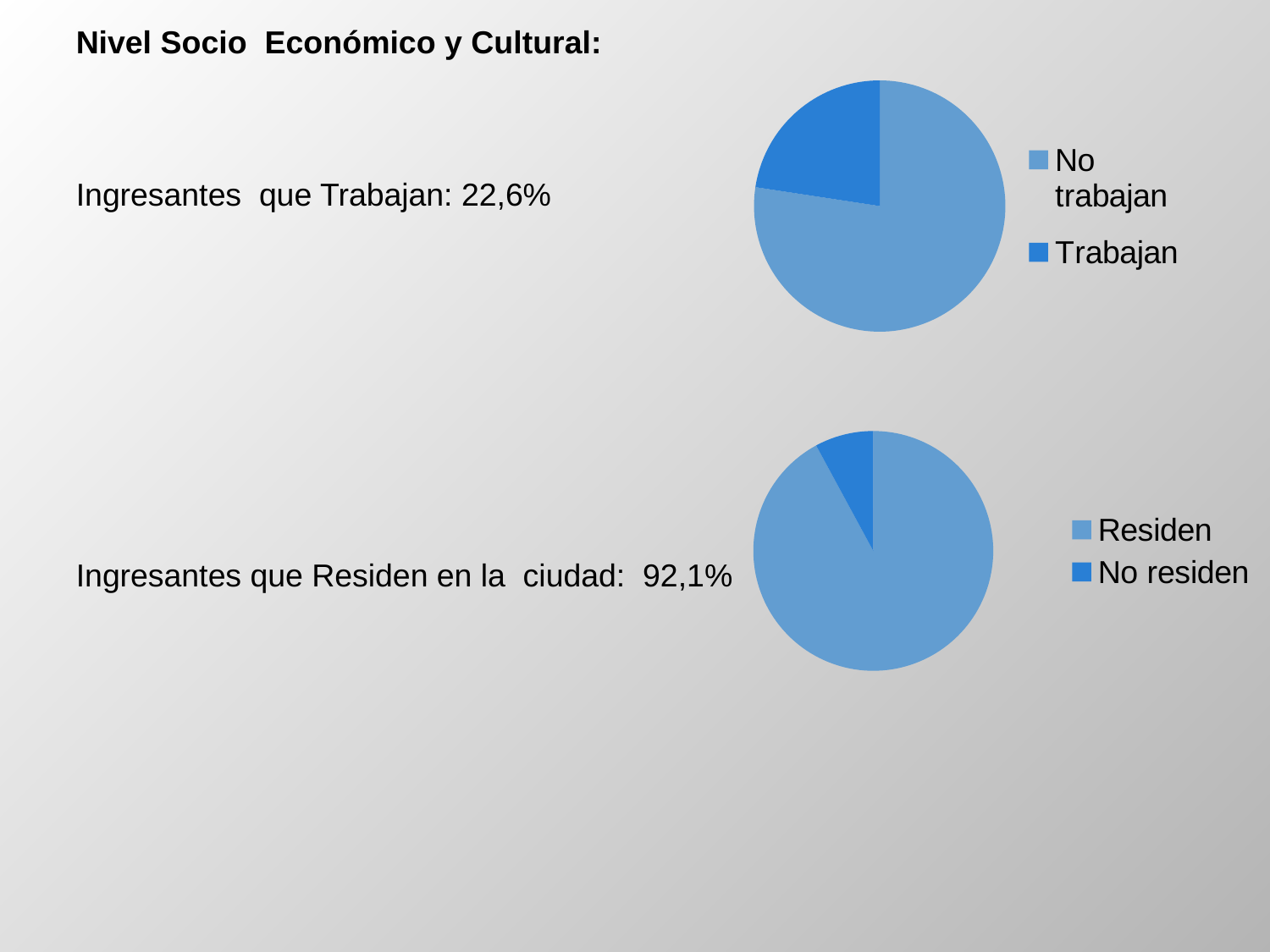
In the bottom pie chart, which slice is the largest? Residen In the top pie chart, which is larger, the 'No trabajan' slice or the 'Trabajan' slice? No trabajan In the top pie chart, which slice is the largest? No trabajan In the bottom pie chart, what share of the pie does the 'Residen' slice represent, according to the text on the slide? 92,1% What kind of chart is the bottom chart on the slide? pie chart In the bottom pie chart, which slice is the smallest? No residen In the top pie chart, how many slices are there? 2 In the bottom pie chart, which is larger, the 'Residen' slice or the 'No residen' slice? Residen In the top pie chart, what share of the pie does the 'Trabajan' slice represent, according to the text on the slide? 22,6% In the bottom pie chart, how many slices are there? 2 In the top pie chart, which slice is the smallest? Trabajan What kind of chart is the top chart on the slide? pie chart